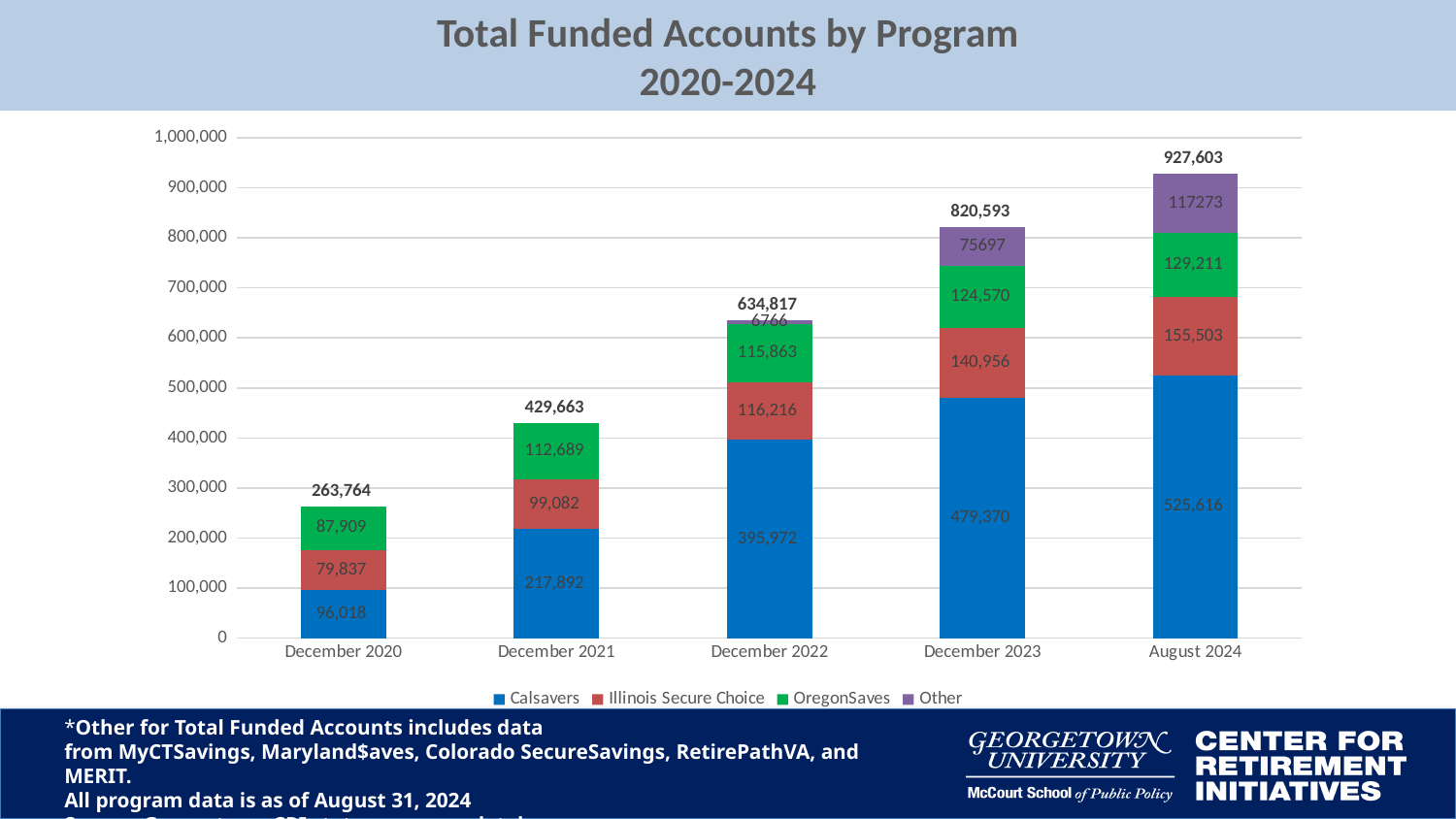
Which period has the highest total funded accounts? August 2024 What is the Illinois Secure Choice value for August 2024? 155,503 Do the total funded accounts rise or fall from December 2020 to August 2024? Rise Which period has the lowest total funded accounts? December 2020 What is the OregonSaves value for December 2021? 112,689 How many series does the legend list? 4 What kind of chart is shown on the slide? Stacked bar chart How many time periods are shown on the x axis? 5 What is the Calsavers value for December 2022? 395,972 Which is larger in December 2020: the Illinois Secure Choice value or the OregonSaves value? OregonSaves What is the difference between the Calsavers values for August 2024 and December 2023? 46,246 What is the total funded accounts for December 2023? 820,593